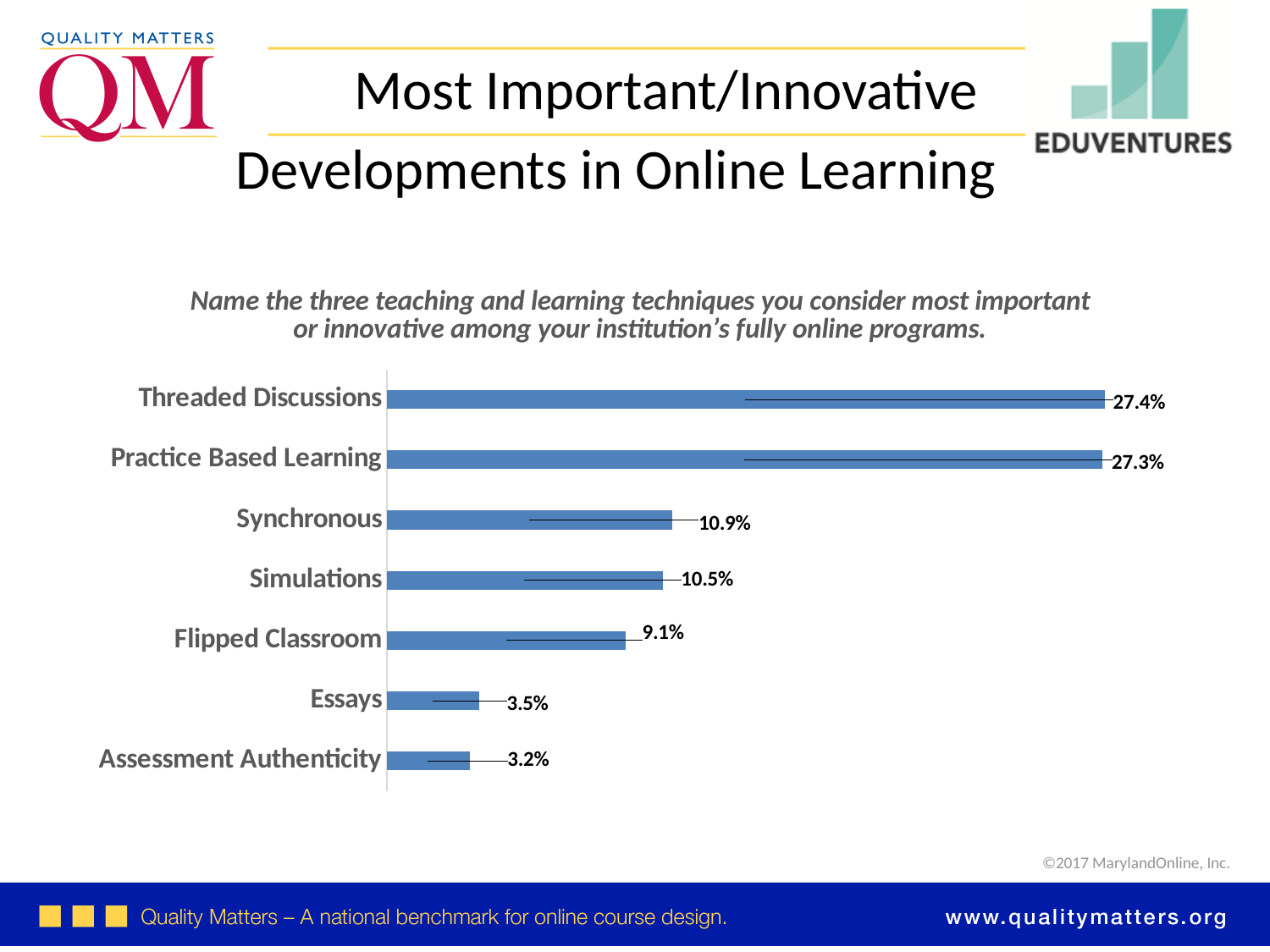
What is the difference between the values for Synchronous and Simulations? 0.4% What kind of chart is shown on the slide? Bar chart What is the value for Assessment Authenticity? 3.2% What is the value for Threaded Discussions? 27.4% What is the value for Synchronous? 10.9% Which category has the lowest value? Assessment Authenticity What is the title of the slide containing the chart? Most Important/Innovative Developments in Online Learning What is the value for Flipped Classroom? 9.1% How many categories are shown in the chart? 7 Which is larger, the value for Essays or the value for Synchronous? Synchronous Which is larger, the value for Simulations or the value for Flipped Classroom? Simulations What is the difference between the values for Threaded Discussions and Practice Based Learning? 0.1%